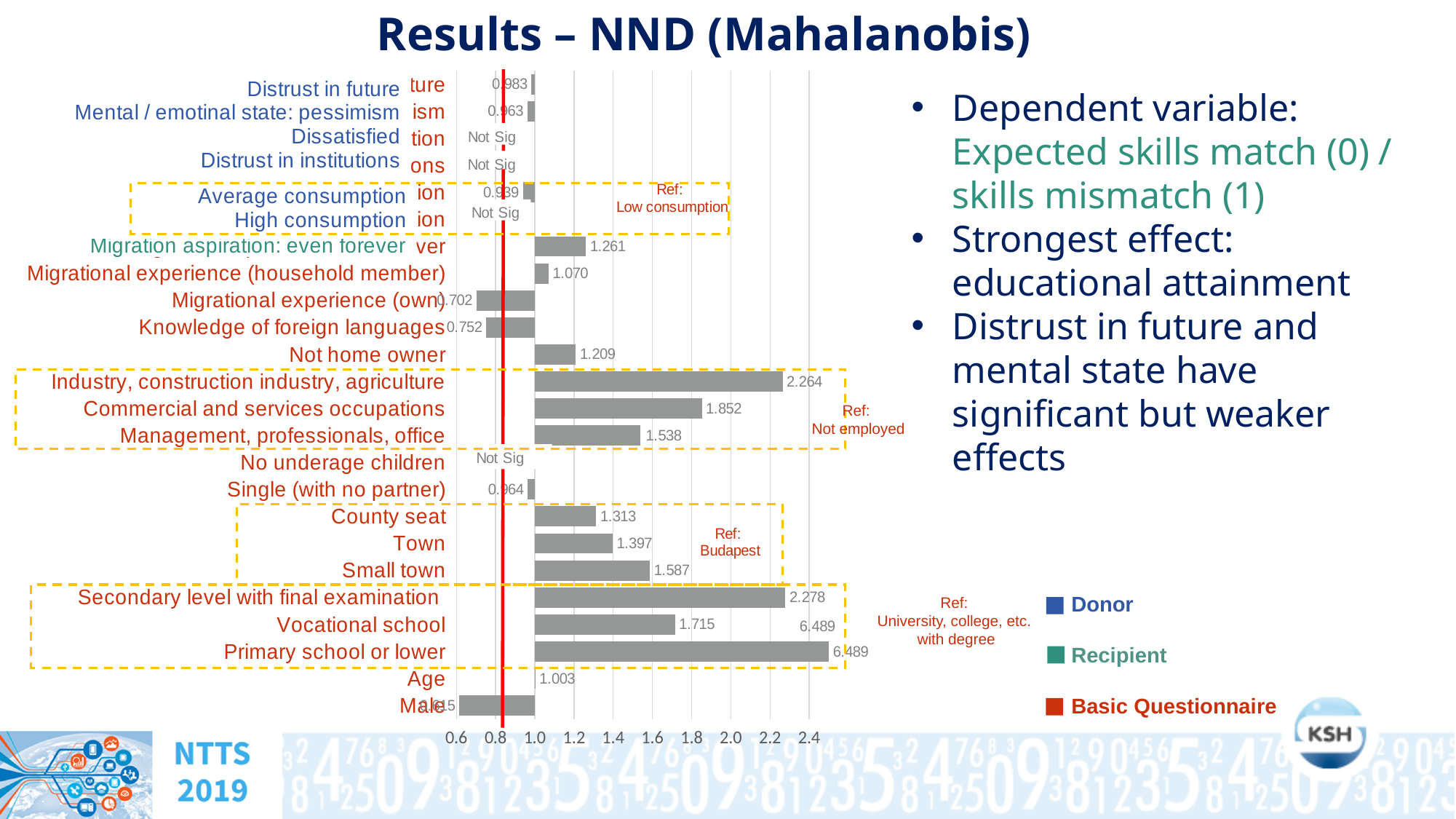
What is the value shown for Small town? 1.587 What is the reference category given for the education group (Secondary level, Vocational school, Primary school or lower)? University, college, etc. with degree What is the value shown for Industry, construction industry, agriculture? 2.264 What is the value shown for Knowledge of foreign languages? 0.752 What is the difference between the values for Secondary level with final examination and Vocational school? 0.563 What is shown for Dissatisfied instead of a bar value? Not Sig Which category has the highest value in the chart? Primary school or lower What kind of chart is shown on the slide? Bar chart What is the difference between the values for Town and County seat? 0.084 Which has the larger value, Commercial and services occupations or Management, professionals, office? Commercial and services occupations What is the value shown for Primary school or lower? 6.489 How many entries does the legend list? 3